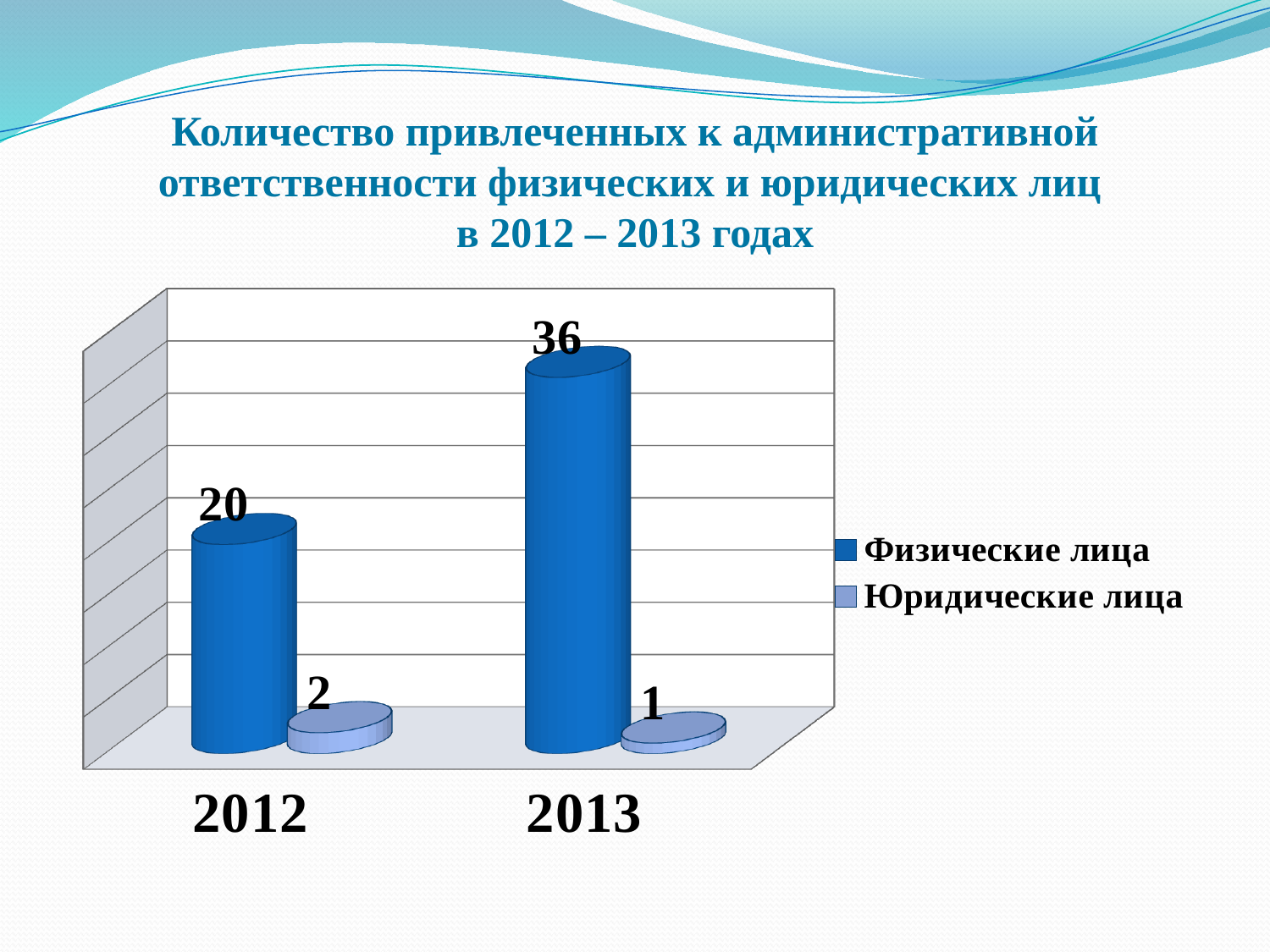
What is the value for Юридические лица in 2012? 2 How many series does the legend list? 2 What is the value for Юридические лица in 2013? 1 In which year is the value for Физические лица highest? 2013 What is the value for Физические лица in 2013? 36 Does the value for Физические лица rise or fall from 2012 to 2013? Rise How many years are shown on the x axis? 2 What kind of chart is shown on the slide? Bar chart In which year is the value for Юридические лица lowest? 2013 What is the value for Физические лица in 2012? 20 What is the difference between the Физические лица values for 2013 and 2012? 16 Which is larger: Физические лица in 2012 or Юридические лица in 2012? Физические лица in 2012